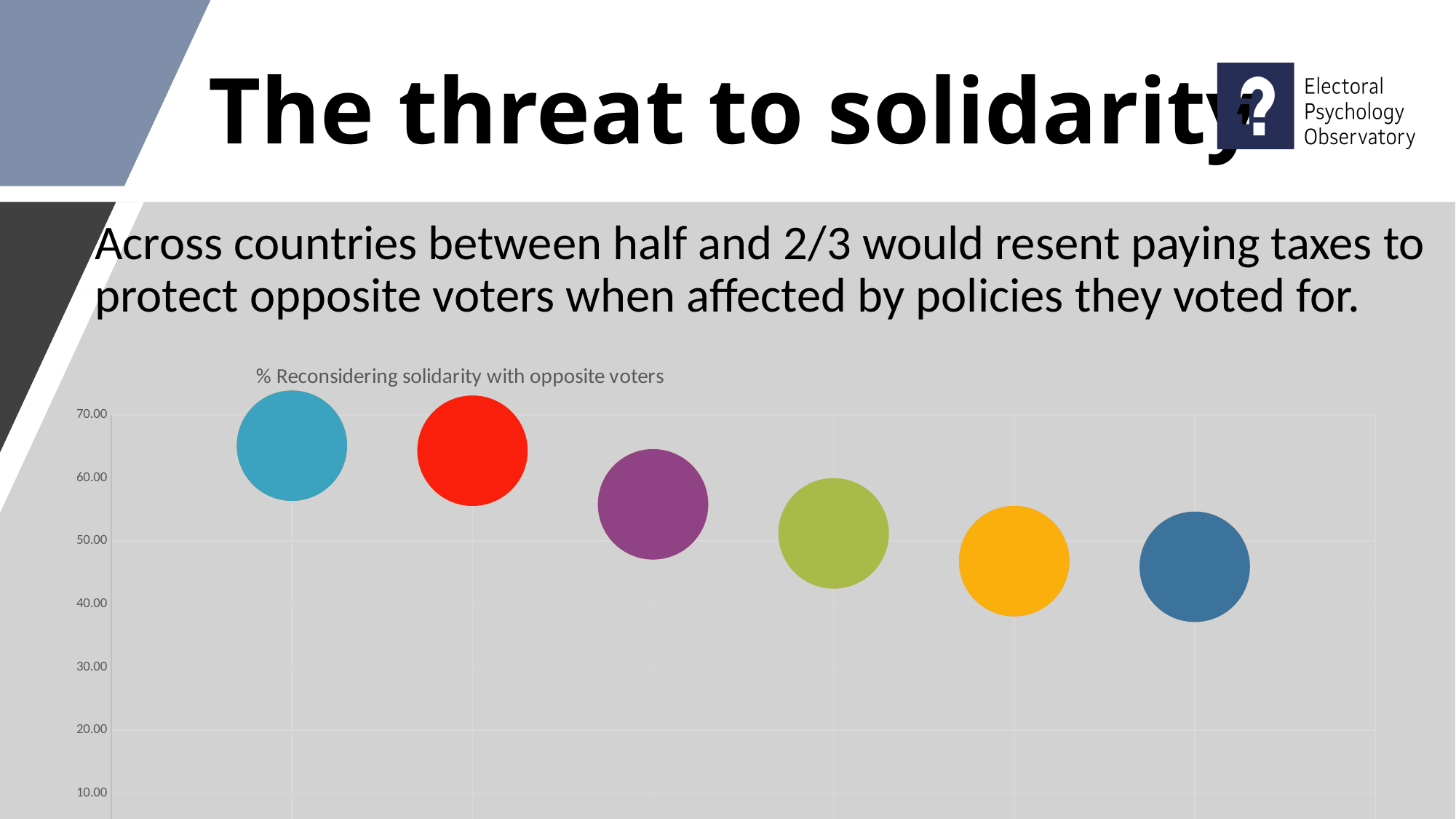
Which has the larger value, the light blue bubble or the purple bubble? the light blue bubble What kind of chart is shown on the slide? bubble chart Is the value for the purple bubble greater or less than 50? greater What is the title of the chart? % Reconsidering solidarity with opposite voters How many bubbles (data points) are plotted in the chart? 6 Is the value for the green bubble greater or less than 60? less Is the value for the dark blue bubble (rightmost) greater or less than 50? less Do the bubble values rise or fall from left to right across the chart? fall What is the highest value shown on the chart's vertical axis? 70.00 Which has the larger value, the green bubble or the dark blue bubble? the green bubble